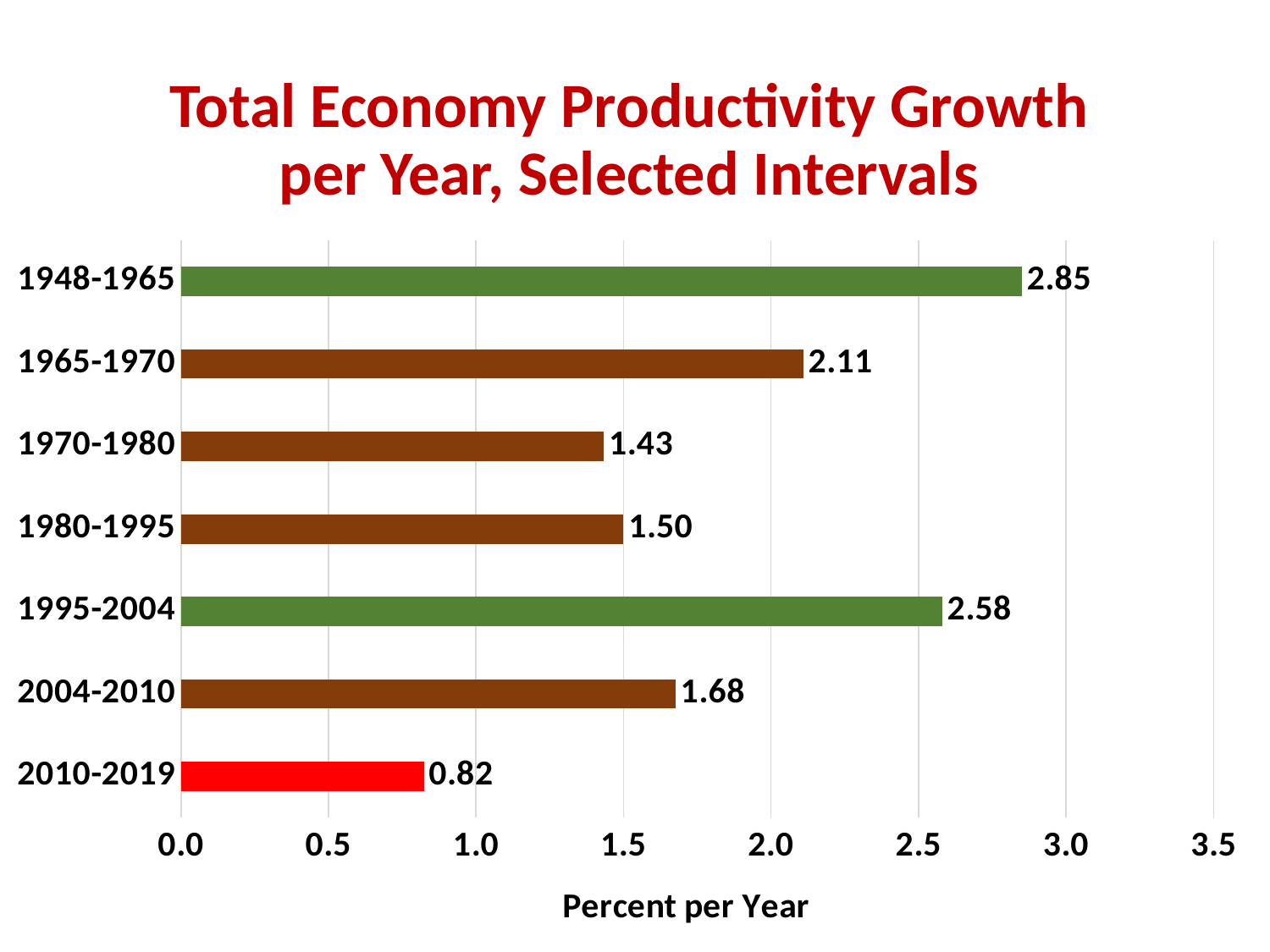
What kind of chart is shown on the slide? bar chart Is the value for 1970-1980 greater or less than 1.5? less What is the difference between the values for 2004-2010 and 2010-2019? 0.86 Which interval has the lowest productivity growth per year? 2010-2019 What is the productivity growth per year for 1948-1965? 2.85 What is the label of the horizontal axis? Percent per Year How many intervals are shown in the chart? 7 What is the difference between the values for 1948-1965 and 1995-2004? 0.27 Which is larger, the value for 1965-1970 or the value for 1980-1995? 1965-1970 What is the productivity growth per year for 1995-2004? 2.58 What is the productivity growth per year for 2010-2019? 0.82 Which interval has the highest productivity growth per year? 1948-1965